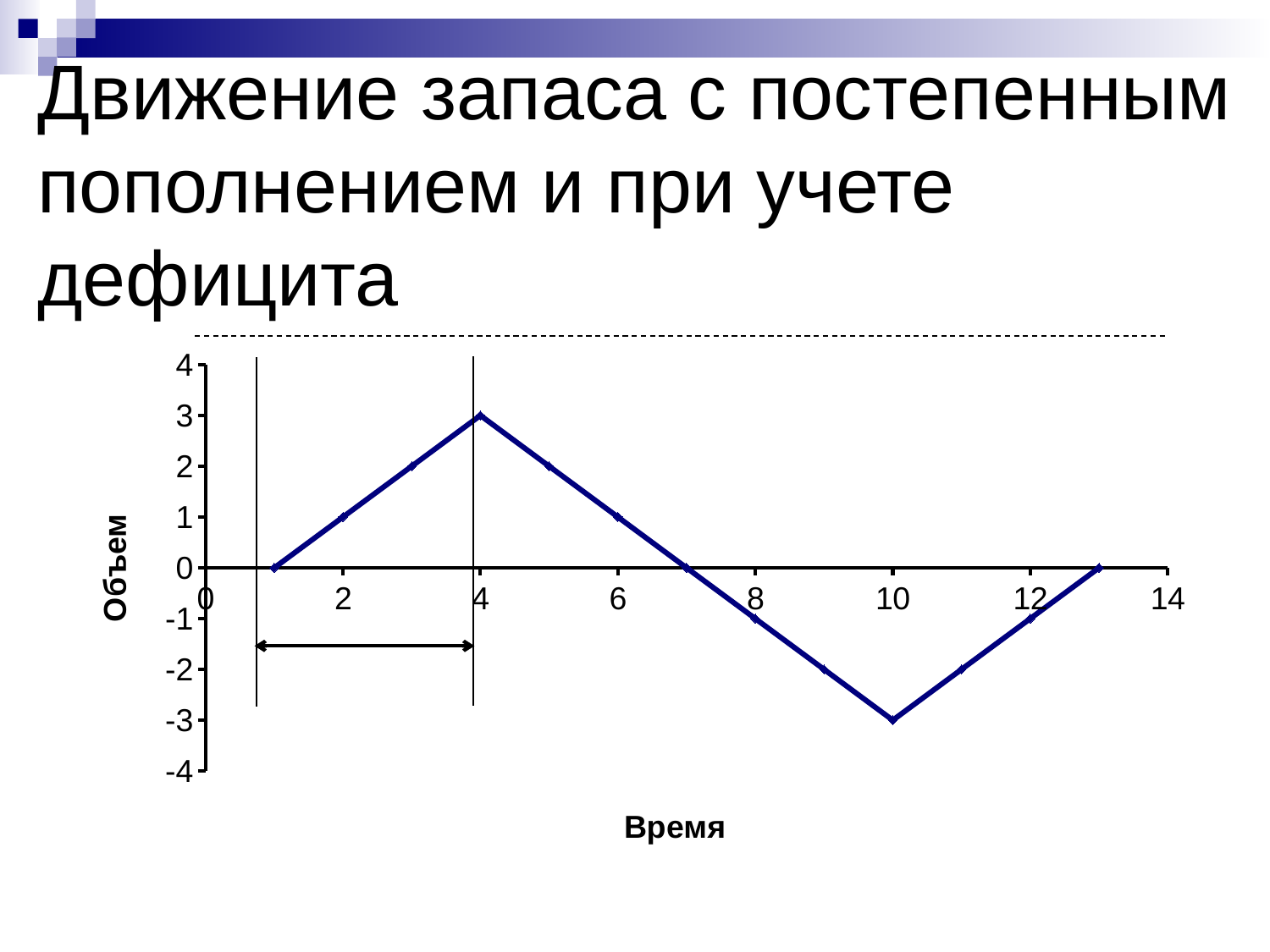
What is the label of the vertical axis? Объем What is the value of Объем at Время = 7? 0 Which is larger: the value at Время = 4 or the value at Время = 10? Время = 4 What is the difference between the highest and lowest values of the line? 6 What is the highest value reached by the line? 3 Is the value of Объем at Время = 6 greater or less than 2? less What is the lowest value reached by the line? -3 What kind of chart is shown on the slide? line chart Does the line rise or fall between Время = 4 and Время = 10? fall What is the label of the horizontal axis? Время What is the value of Объем at Время = 4? 3 What is the value of Объем at Время = 10? -3